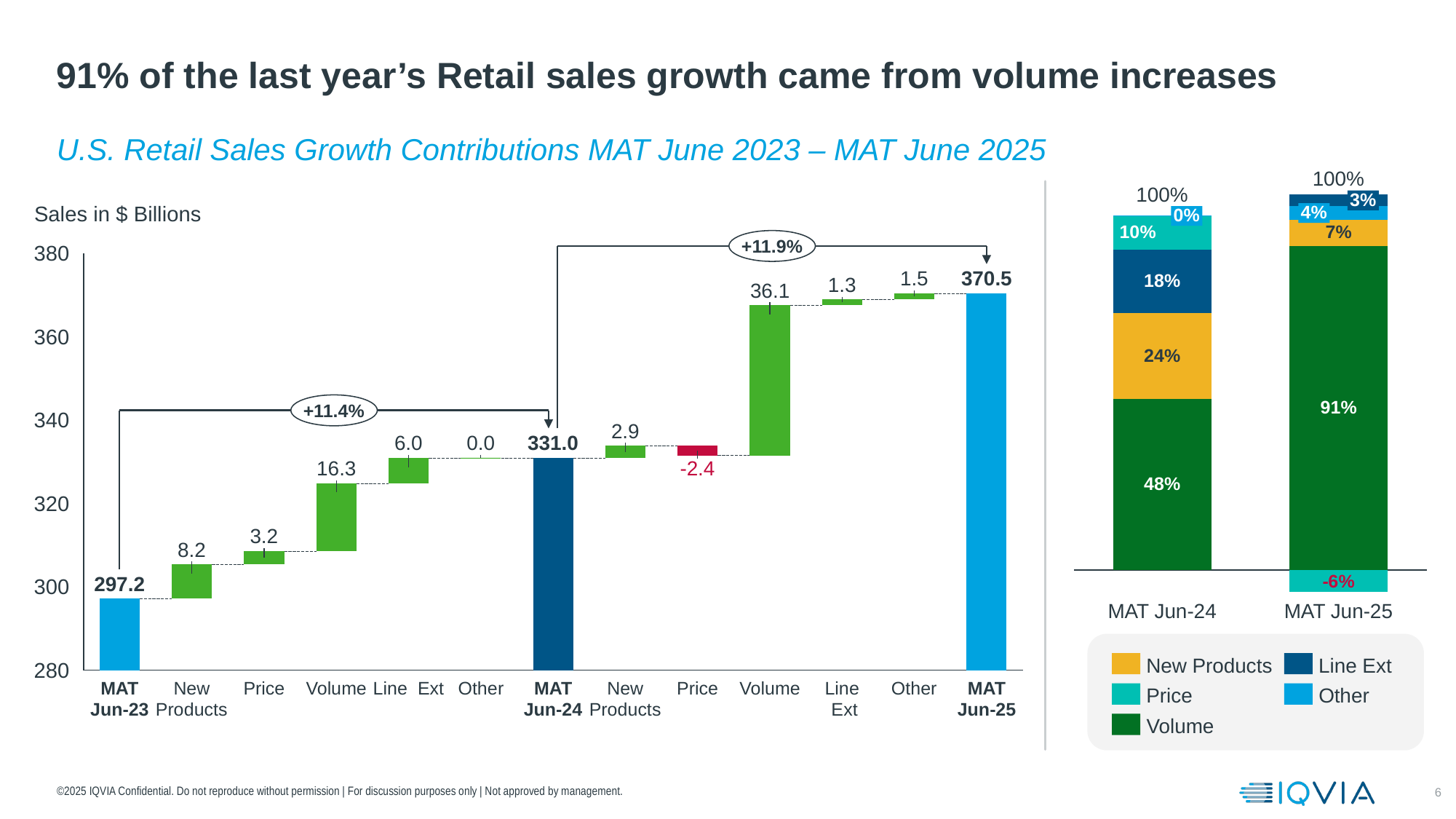
In the waterfall chart on the left, what is the sales value for MAT Jun-25? 370.5 In the waterfall chart on the left, what percentage growth is shown from MAT Jun-24 to MAT Jun-25? +11.9% In the waterfall chart on the left, what is the Volume contribution between MAT Jun-24 and MAT Jun-25? 36.1 In the waterfall chart on the left, what is the difference between the MAT Jun-24 and MAT Jun-23 sales values? 33.8 What kind of chart is shown on the right side of the slide? Stacked bar chart In the waterfall chart on the left, what is the Price contribution between MAT Jun-24 and MAT Jun-25? -2.4 In the waterfall chart on the left, which contribution between MAT Jun-23 and MAT Jun-24 is the largest? Volume In the stacked bar chart on the right, what is the Price share in MAT Jun-25? -6% How many series does the legend of the stacked bar chart on the right list? 5 In the stacked bar chart on the right, what share of growth does Volume account for in MAT Jun-25? 91% In the waterfall chart on the left, is the Volume contribution between MAT Jun-23 and MAT Jun-24 larger or smaller than the New Products contribution in the same period? larger In the stacked bar chart on the right, what share of growth does New Products account for in MAT Jun-24? 24%